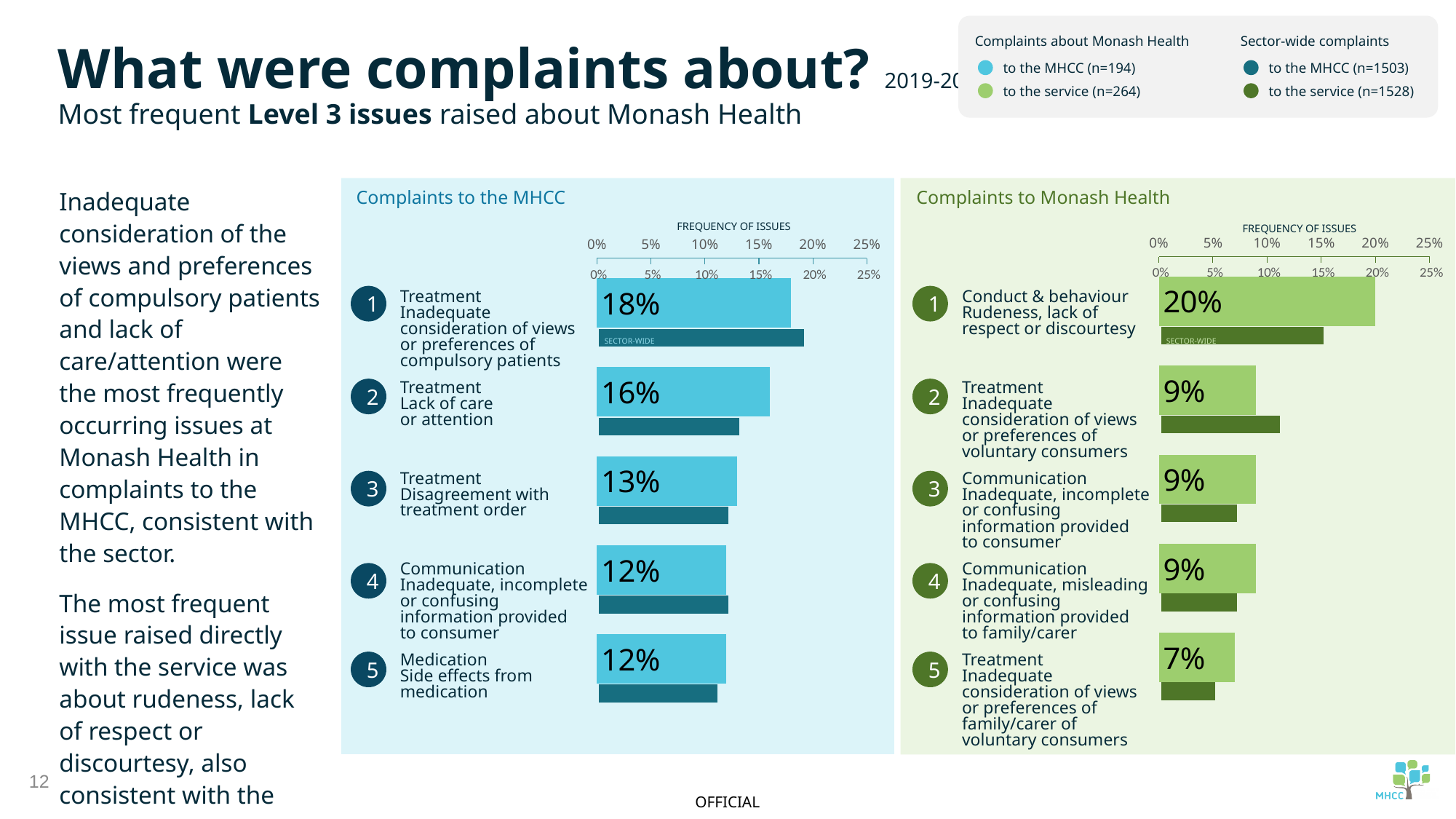
In the 'Complaints to Monash Health' chart, for issue 1 (Conduct & behaviour), is the Monash Health bar or the sector-wide bar larger? Monash Health bar How many issues are listed in the 'Complaints to Monash Health' chart? 5 In the 'Complaints to the MHCC' chart, what is the difference between the frequency of issue 1 (18%) and issue 2 (16%)? 2% In the 'Complaints to Monash Health' chart, which issue has the lowest frequency? Treatment – Inadequate consideration of views or preferences of family/carer of voluntary consumers In the 'Complaints to the MHCC' chart, which issue has the highest frequency? Treatment – Inadequate consideration of views or preferences of compulsory patients In the 'Complaints to Monash Health' chart, what is the frequency for issue 1, Conduct & behaviour – Rudeness, lack of respect or discourtesy? 20% In the 'Complaints to Monash Health' chart, what is the difference between the frequency of issue 1 (20%) and issue 5 (7%)? 13% In the 'Complaints to Monash Health' chart, what is the frequency for issue 5, Treatment – Inadequate consideration of views or preferences of family/carer of voluntary consumers? 7% In the 'Complaints to the MHCC' chart, what is the frequency for issue 1, Treatment – Inadequate consideration of views or preferences of compulsory patients? 18% What type of chart is used in the 'Complaints to the MHCC' panel? Bar chart In the 'Complaints to the MHCC' chart, what is the frequency for issue 3, Treatment – Disagreement with treatment order? 13% In the 'Complaints to the MHCC' chart, is the sector-wide value for issue 1 greater or less than 15%? greater